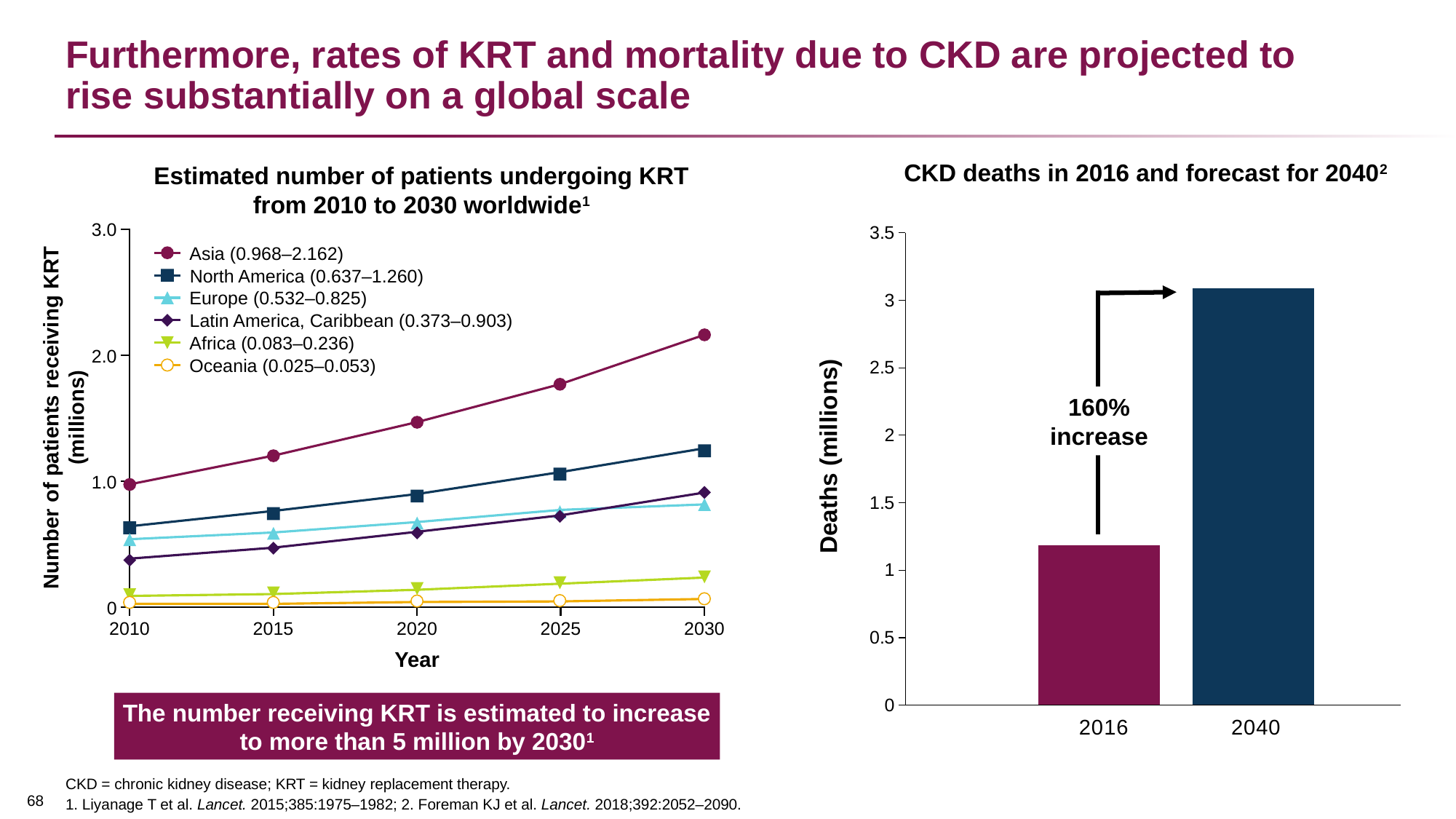
What kind of chart is the 'Estimated number of patients undergoing KRT from 2010 to 2030 worldwide' chart? Line chart In the 'Estimated number of patients undergoing KRT' chart, how many years are plotted along the x axis? 5 In the 'CKD deaths in 2016 and forecast for 2040' chart, which year has the higher number of deaths? 2040 In the 'Estimated number of patients undergoing KRT' chart, is the value for Asia in 2030 greater or less than 2.0 million? greater In the 'CKD deaths in 2016 and forecast for 2040' chart, what percentage increase is labelled between 2016 and 2040? 160% In the 'Estimated number of patients undergoing KRT' chart, does the number of patients for Asia rise or fall from 2010 to 2030? Rise What kind of chart is the 'CKD deaths in 2016 and forecast for 2040' chart? Bar chart In the 'Estimated number of patients undergoing KRT' chart, which region has the highest number of patients in 2030? Asia In the 'Estimated number of patients undergoing KRT' chart, which region has the lowest number of patients in 2030? Oceania In the 'Estimated number of patients undergoing KRT' chart, what range does the legend give for Africa? 0.083–0.236 How many series does the legend of the 'Estimated number of patients undergoing KRT' chart list? 6 In the 'Estimated number of patients undergoing KRT' chart, is the value for Europe in 2030 greater or less than 1.0 million? less